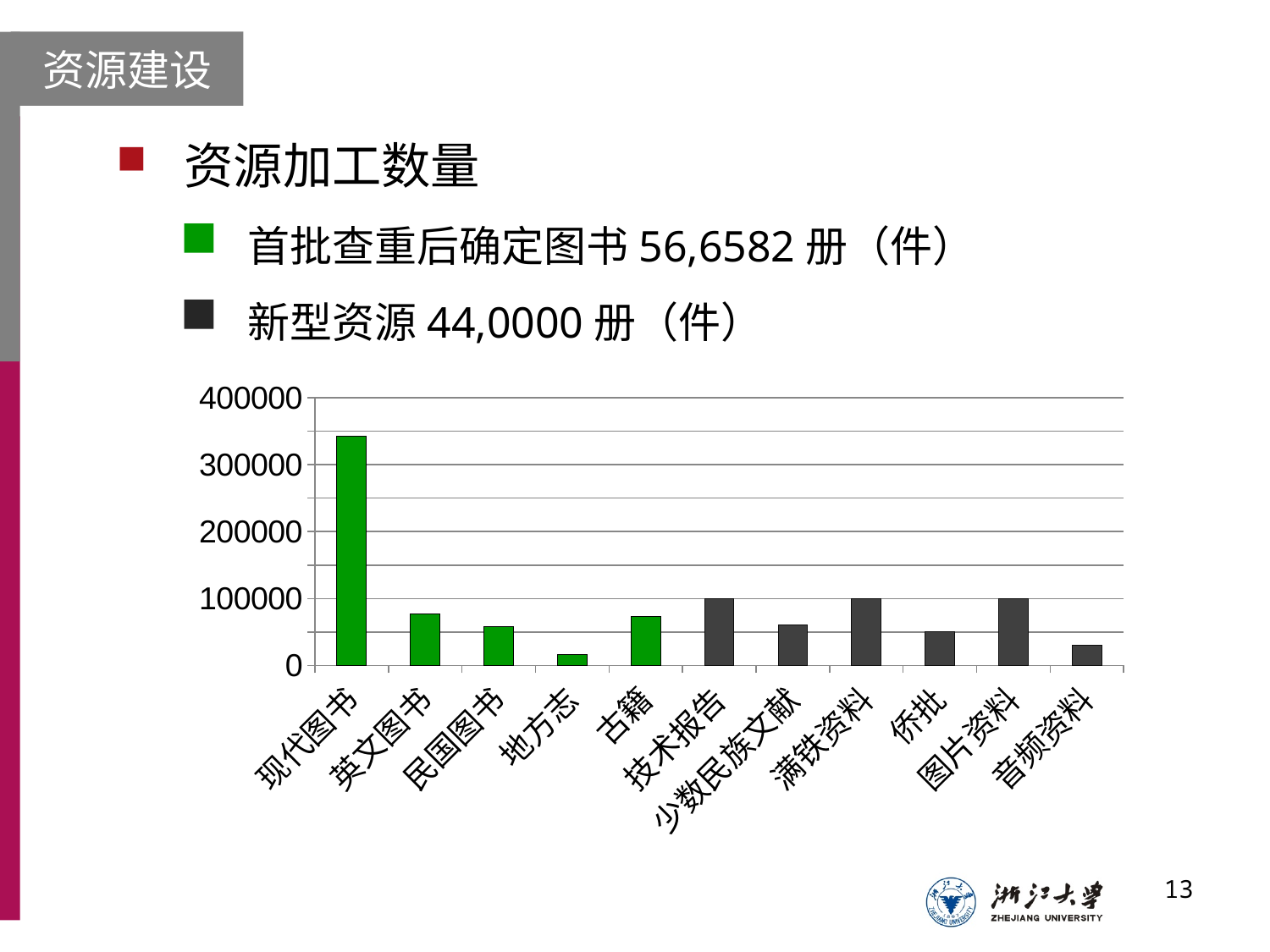
Which category has the lowest value in the chart? 地方志 Is the value for 音频资料 greater or less than 100000? less Which category has the highest value in the chart? 现代图书 Is the value for 现代图书 greater or less than 300000? greater Which is larger, the value for 现代图书 or the value for 英文图书? 现代图书 Is the value for 英文图书 greater or less than 100000? less Which is larger, the value for 侨批 or the value for 音频资料? 侨批 Which is larger, the value for 英文图书 or the value for 地方志? 英文图书 What kind of chart is shown on the slide? bar chart How many bars in the chart are coloured green? 5 How many categories are plotted on the x axis of the chart? 11